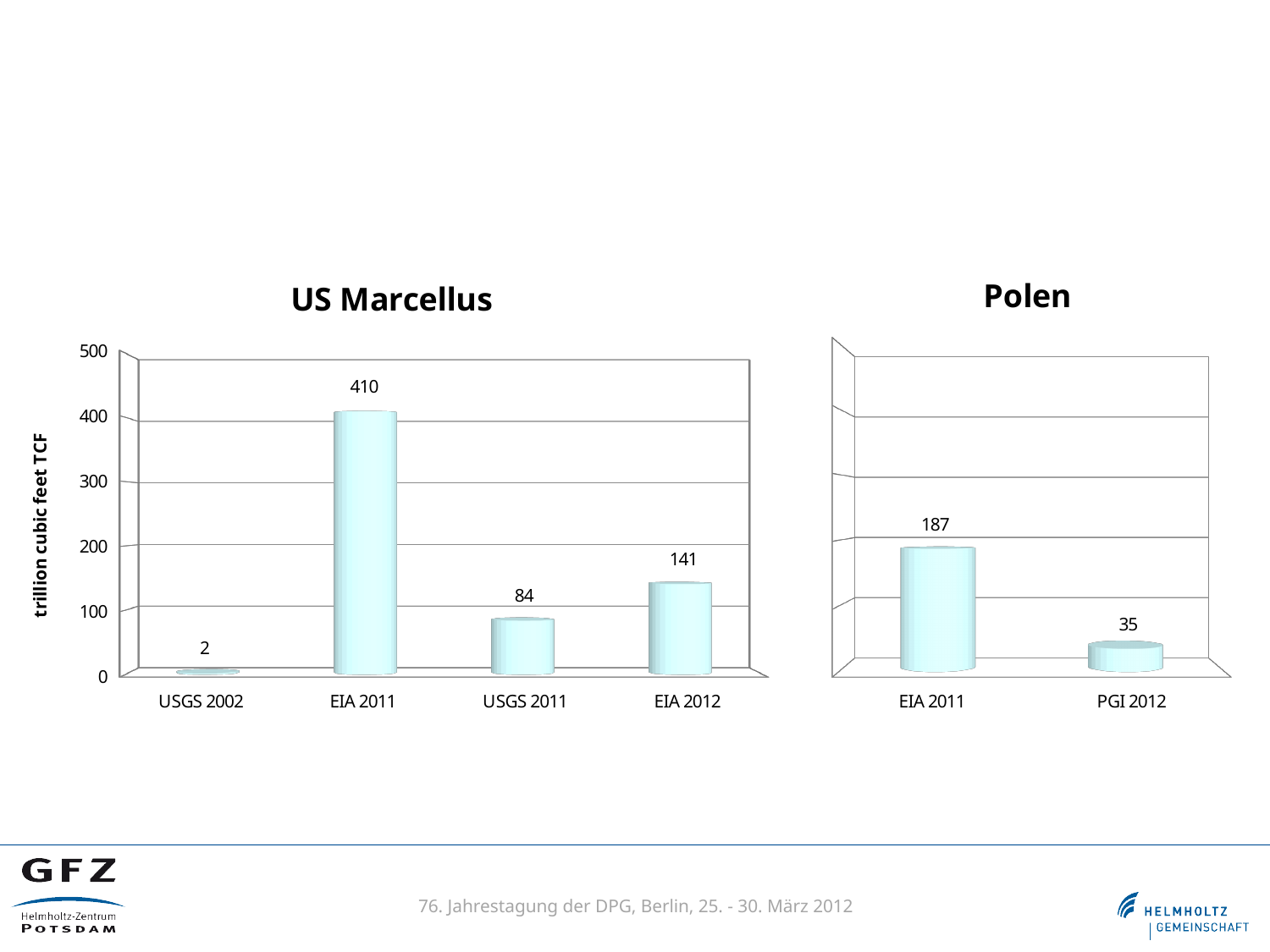
In the Polen chart, which category has the higher value? EIA 2011 Which is larger: the EIA 2011 value in the US Marcellus chart or the EIA 2011 value in the Polen chart? US Marcellus EIA 2011 In the Polen chart, what is the difference between the EIA 2011 and PGI 2012 values? 152 What is the y-axis label of the US Marcellus chart? trillion cubic feet TCF In the US Marcellus chart, what is the value for EIA 2011? 410 In the US Marcellus chart, what is the value for USGS 2011? 84 What kind of chart is the Polen chart? bar chart In the Polen chart, what is the value for PGI 2012? 35 In the US Marcellus chart, which category has the highest value? EIA 2011 In the US Marcellus chart, which category has the lowest value? USGS 2002 How many categories are shown in the US Marcellus chart? 4 In the US Marcellus chart, what is the difference between the EIA 2012 and USGS 2011 values? 57